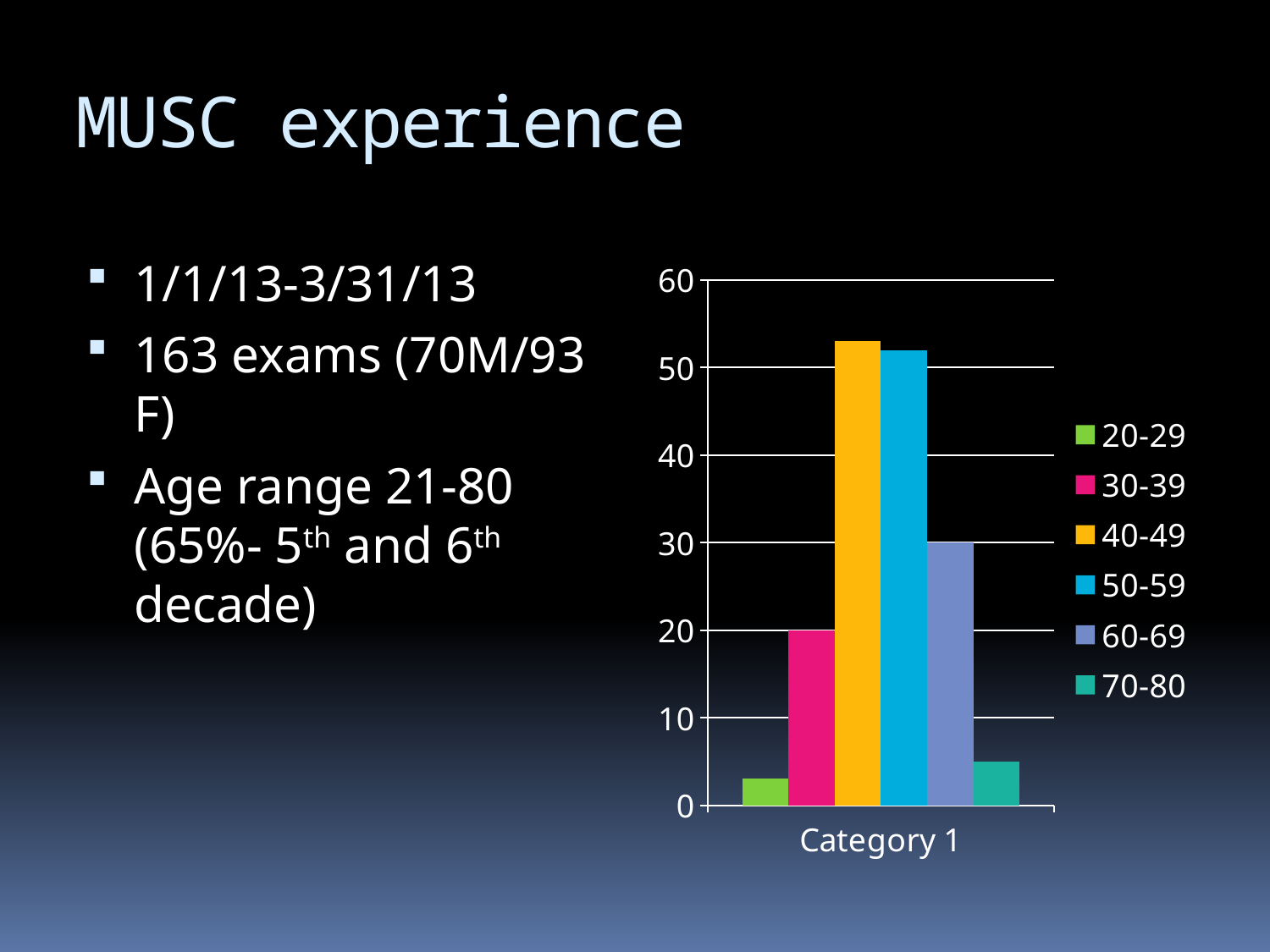
Is the value for 20-29 greater or less than 10? less How many categories are shown on the x axis? 1 Which series has the lowest value? 20-29 Is the value for 40-49 greater or less than 50? greater Which is larger, the value for 40-49 or the value for 60-69? 40-49 What is the value for the 60-69 series? 30 How many series does the legend list? 6 What is the value for the 30-39 series? 20 Is the value for 70-80 greater or less than 10? less What is the difference between the values for 60-69 and 30-39? 10 What is the label on the x axis of the chart? Category 1 What type of chart is shown on the slide? bar chart